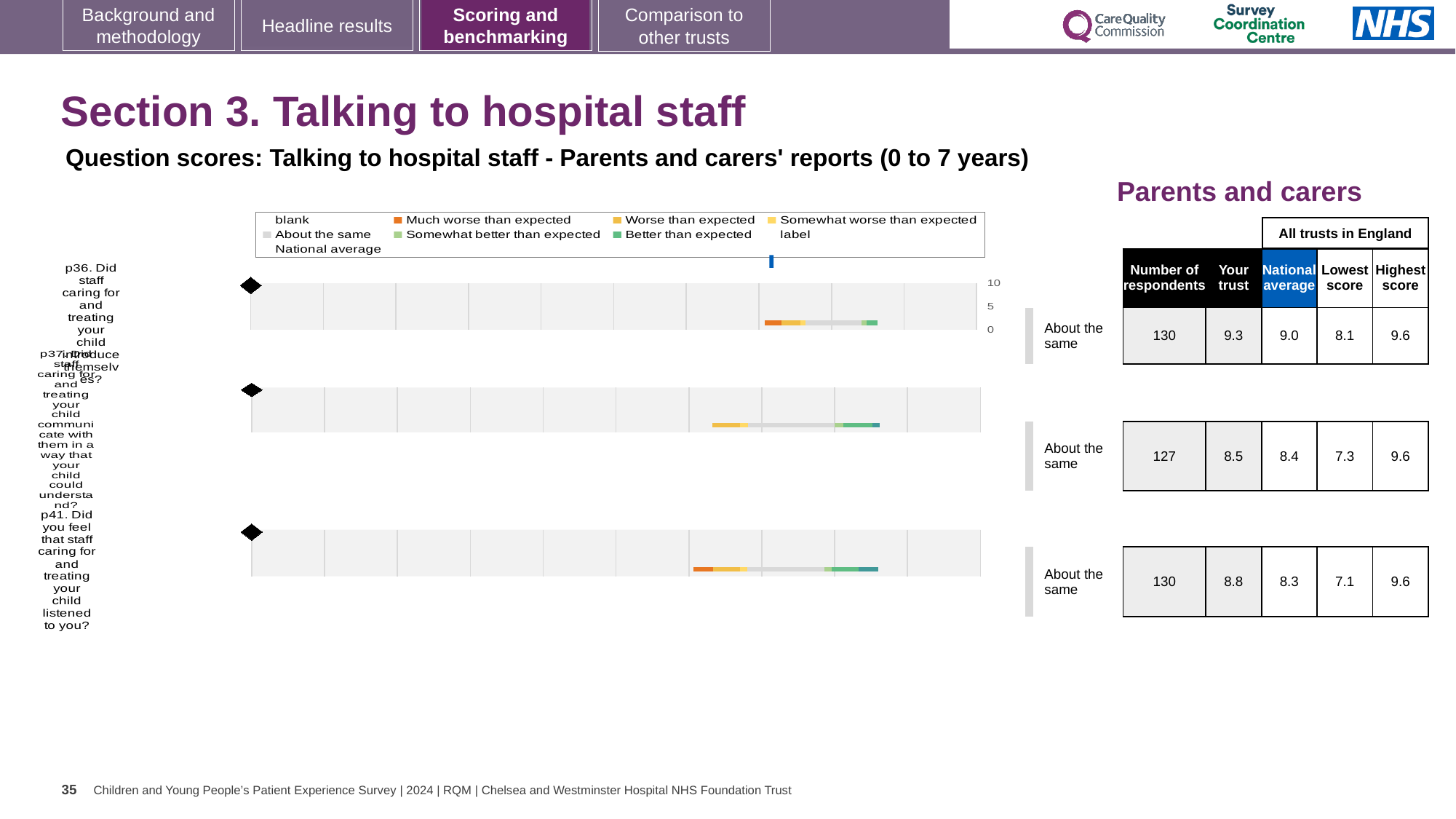
Which question has the highest 'Your trust' score? p36 What is the highest score across all trusts in England for question p41? 9.6 How many respondents answered question p37? 127 How many survey questions (rows) are plotted in the chart? 3 What is the difference between the 'Your trust' score and the national average for question p36? 0.3 What is the 'Your trust' score for question p36 (Did staff caring for and treating your child introduce themselves)? 9.3 What kind of chart is used to show the question scores on this slide? bar chart What is the national average score for question p37 (Did staff communicate with them in a way your child could understand)? 8.4 What colour does the legend use for 'Much worse than expected'? orange For question p41, which is larger: the 'Your trust' score or the national average? Your trust What benchmark category is shown for all three questions on the slide? About the same Which question has the lowest 'Lowest score' value across all trusts in England? p41